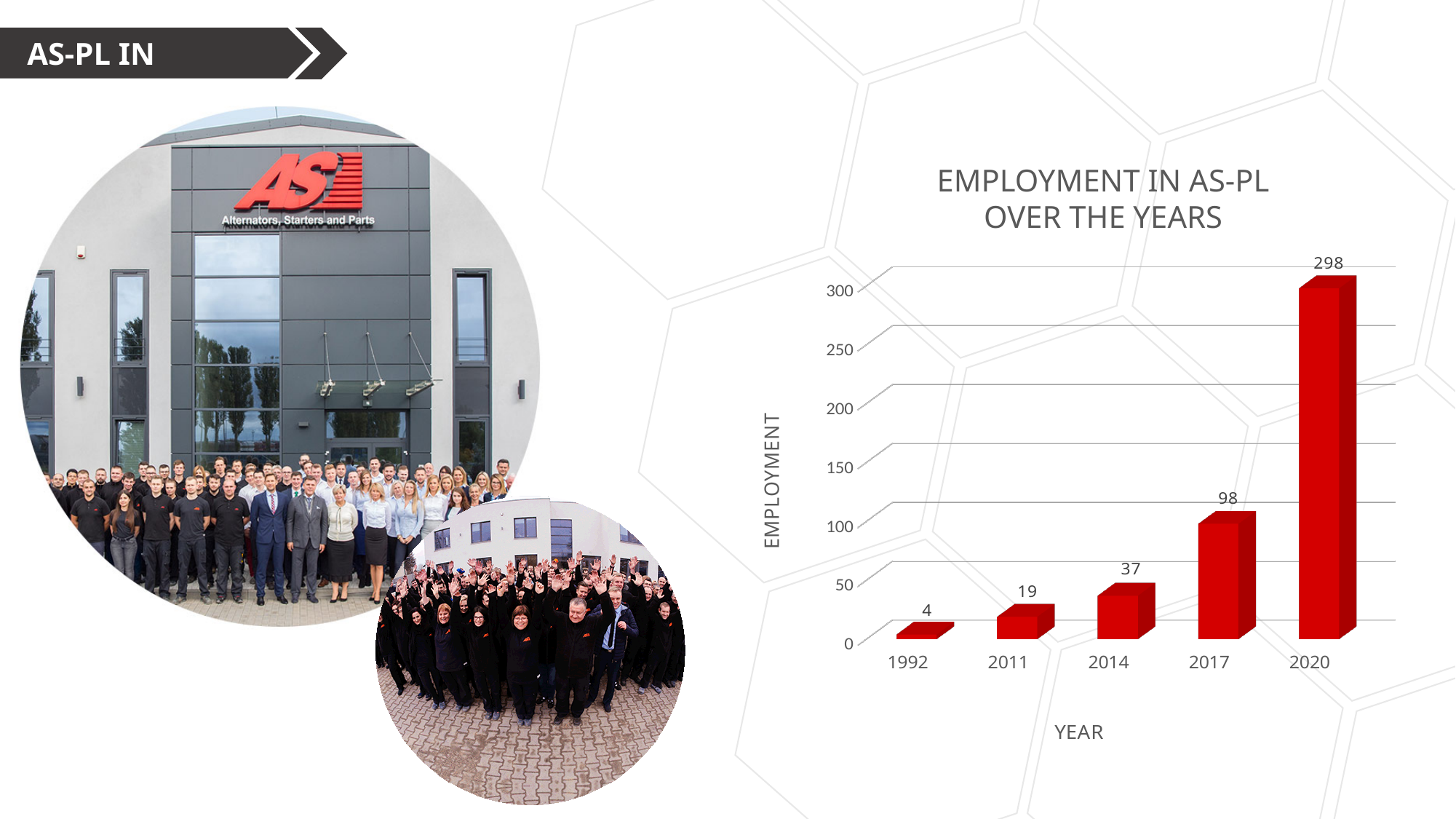
Which year has the lowest employment? 1992 Which year has the highest employment? 2020 What is the difference in employment between 2014 and 2011? 18 What was the employment in AS-PL in 2017? 98 Does employment rise or fall from 1992 to 2020? Rise What kind of chart is used to show employment over the years? Bar chart What was the employment in AS-PL in 1992? 4 How many years are shown on the x axis of the chart? 5 What was the employment in AS-PL in 2020? 298 What was the employment in AS-PL in 2014? 37 What is the difference in employment between 2020 and 2017? 200 Which year had higher employment, 2011 or 2017? 2017